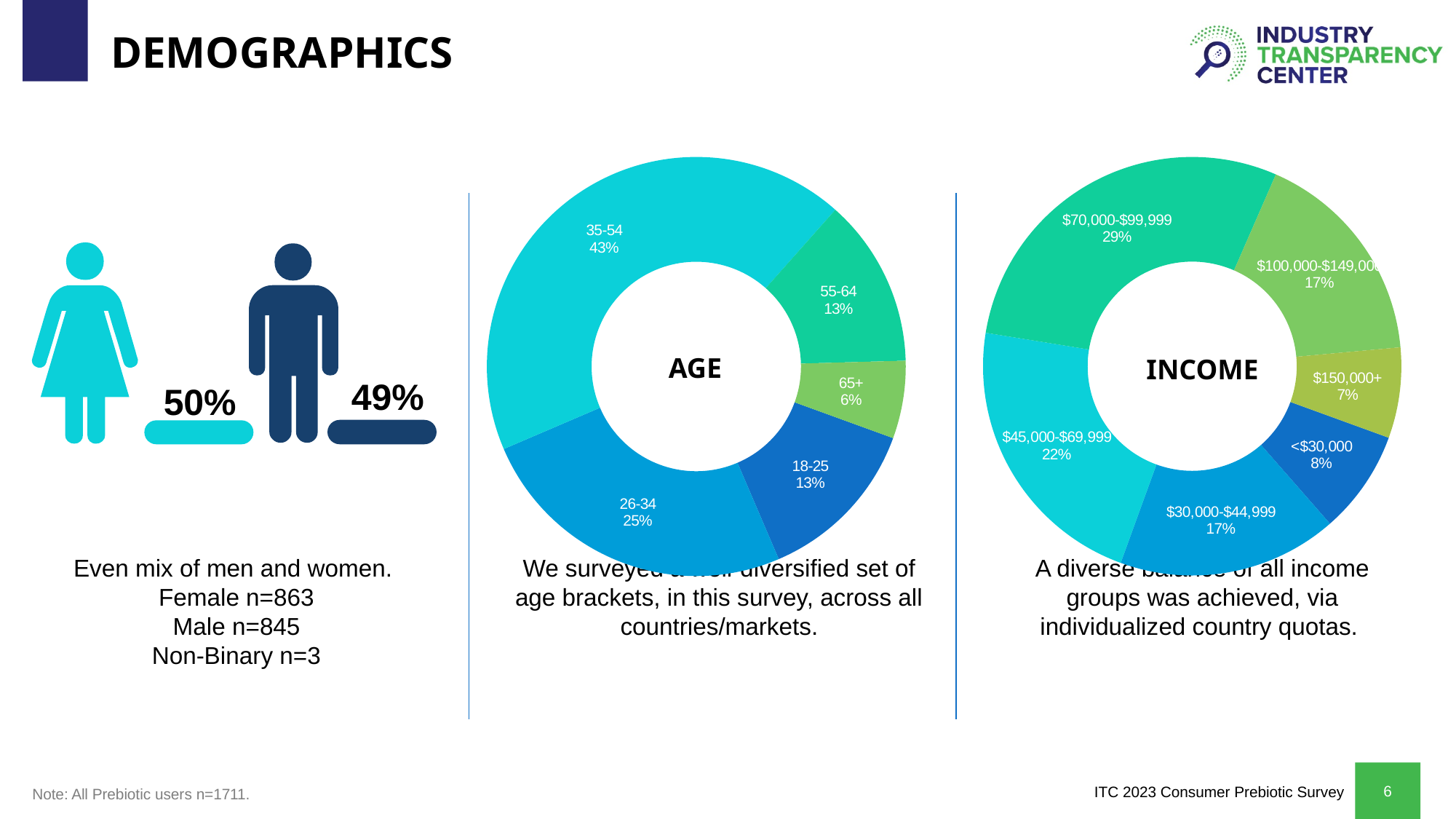
In the AGE chart, which age bracket has the largest share? 35-54 In the INCOME chart, which income group has the smallest share? $150,000+ In the INCOME chart, what share of respondents earn less than $30,000? 8% In the INCOME chart, which income group has the largest share? $70,000-$99,999 In the AGE chart, how many age brackets are shown? 5 In the AGE chart, what share of respondents are aged 26-34? 25% In the AGE chart, which age bracket has the smallest share? 65+ In the INCOME chart, what share of respondents earn $70,000-$99,999? 29% In the INCOME chart, which is larger: the share for $45,000-$69,999 or the share for $30,000-$44,999? $45,000-$69,999 In the AGE chart, what share of respondents are aged 35-54? 43% What type of chart is used for the AGE and INCOME breakdowns? Donut (pie) chart In the AGE chart, what is the difference in percentage points between the 35-54 and 26-34 brackets? 18